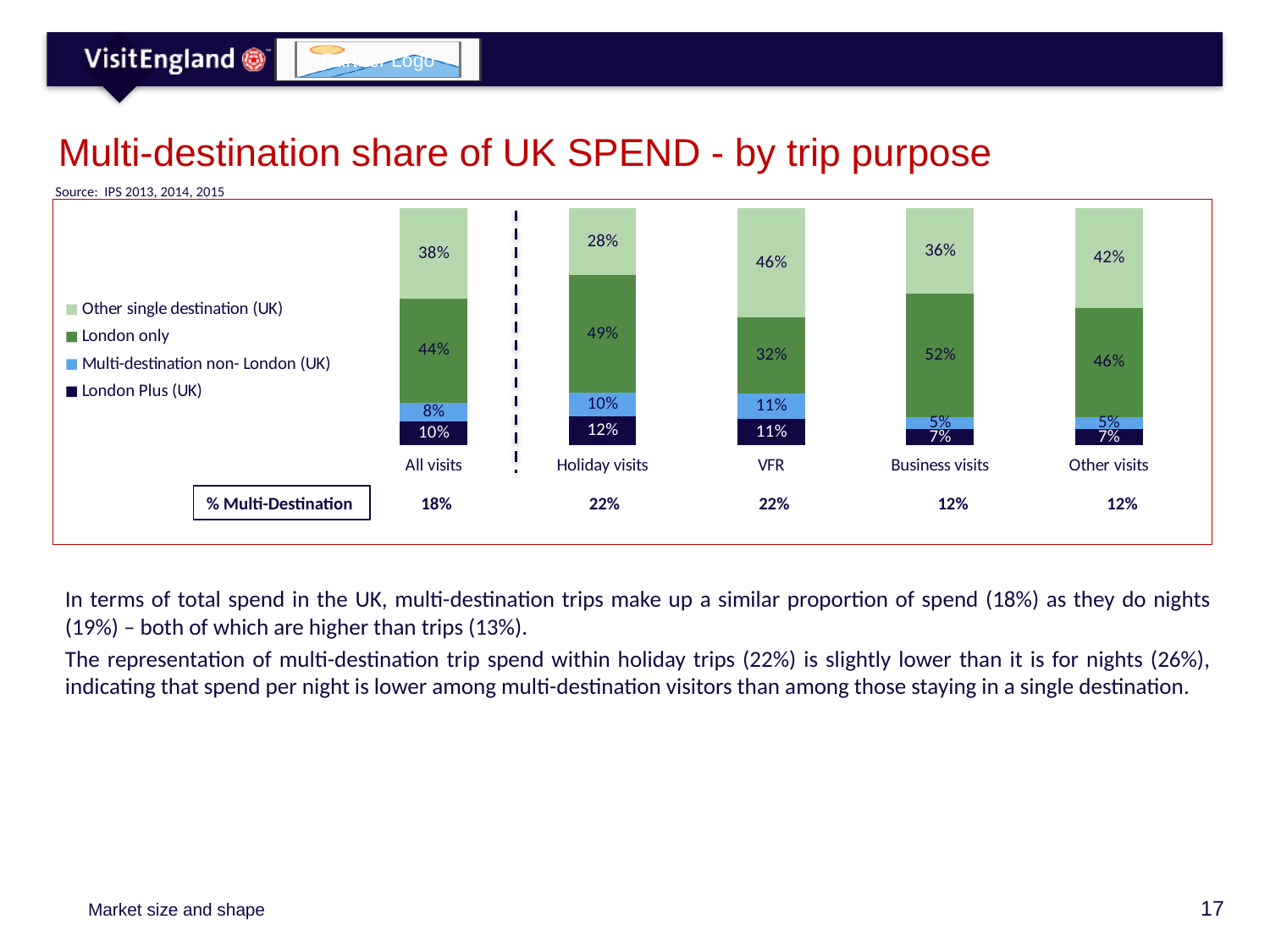
What is the London Plus (UK) share for Holiday visits? 12% What is the difference between the London only share for Holiday visits and for VFR? 17% Which trip purpose has the lowest Other single destination (UK) share? Holiday visits What is the London only share of UK spend for Business visits? 52% What type of chart is shown on the slide? Stacked bar chart How many trip purpose categories are plotted along the x axis? 5 Which is larger: the Other single destination (UK) share for Other visits or for All visits? Other visits What is the % Multi-Destination figure shown for Holiday visits? 22% Which trip purpose has the highest London only share? Business visits What is the Other single destination (UK) share for VFR? 46% What is the Multi-destination non-London (UK) share for All visits? 8% How many series does the legend list? 4